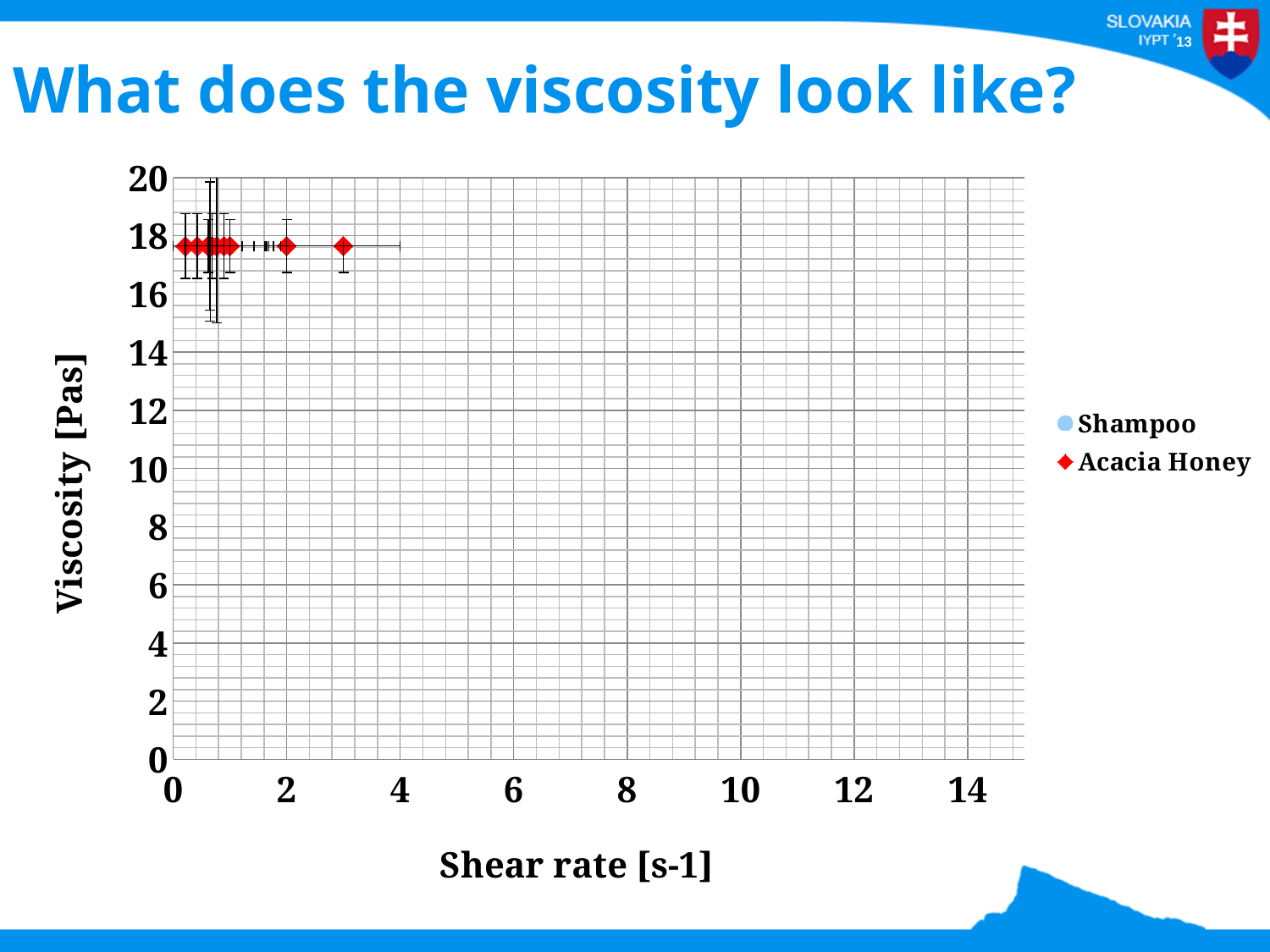
Are the Acacia Honey viscosity values greater or less than 10 Pas? greater What are the two series named in the legend? Shampoo and Acacia Honey Is the viscosity of Acacia Honey at a shear rate of about 2 s-1 greater or less than 20? less Is the viscosity of Acacia Honey at a shear rate of about 3 s-1 greater or less than 16? greater Does the viscosity of Acacia Honey rise, fall, or stay roughly constant as the shear rate increases? stays roughly constant What kind of chart is shown on the slide? scatter chart Which series is plotted with red diamond markers? Acacia Honey What is the label of the y axis? Viscosity [Pas] How many series does the legend list? 2